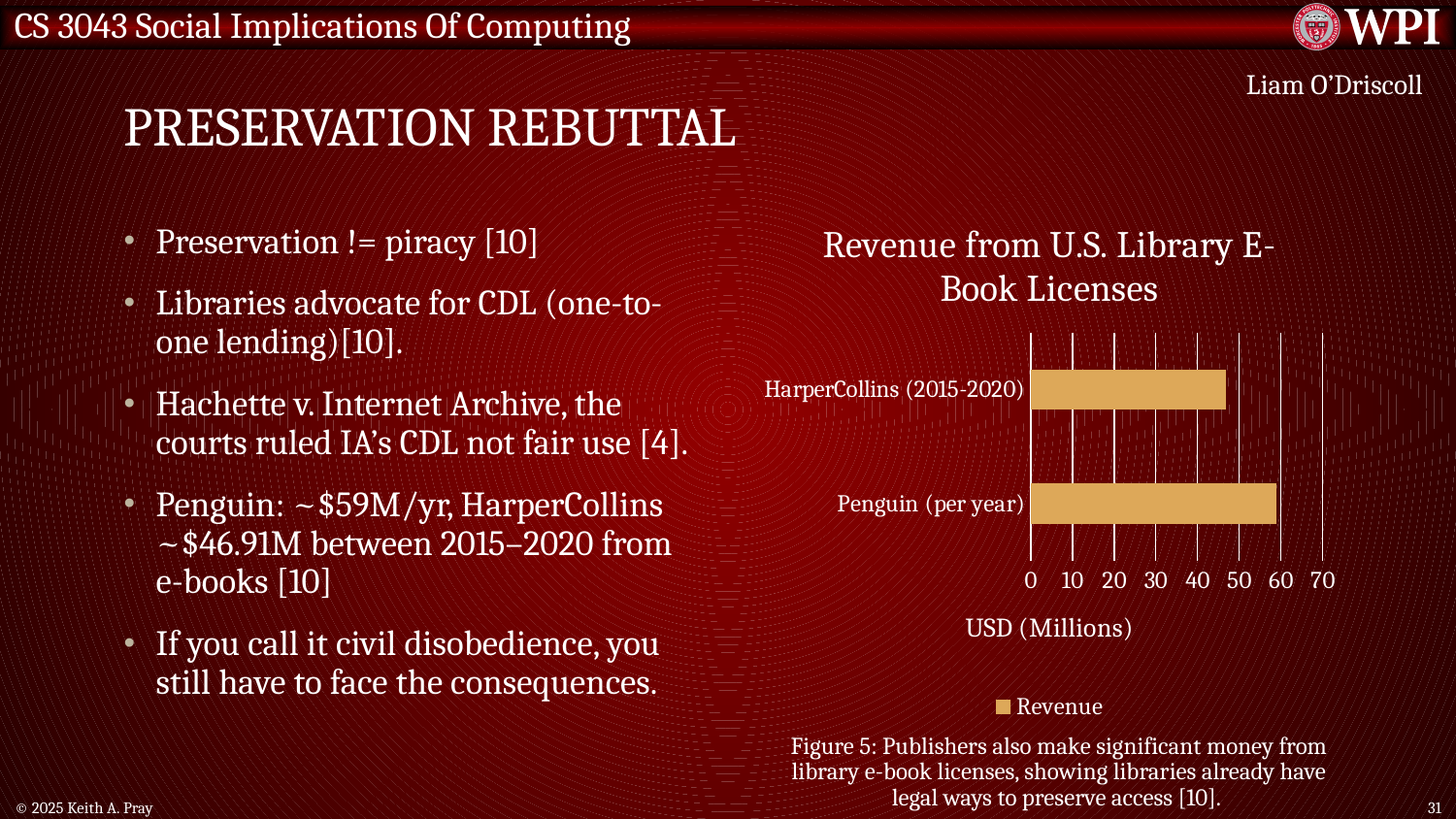
What kind of chart is shown on the slide? bar chart How many series does the chart's legend list? 1 Which category has the highest revenue in the chart? Penguin (per year) What series name is shown in the chart's legend? Revenue Is the value for HarperCollins (2015-2020) greater or less than 40? greater Is the value for HarperCollins (2015-2020) greater or less than 50? less Which is larger, the revenue for Penguin (per year) or for HarperCollins (2015-2020)? Penguin (per year) How many categories are plotted in the chart? 2 Which category has the lowest revenue in the chart? HarperCollins (2015-2020) What is the title of the chart? Revenue from U.S. Library E-Book Licenses Is the value for Penguin (per year) greater or less than 50? greater